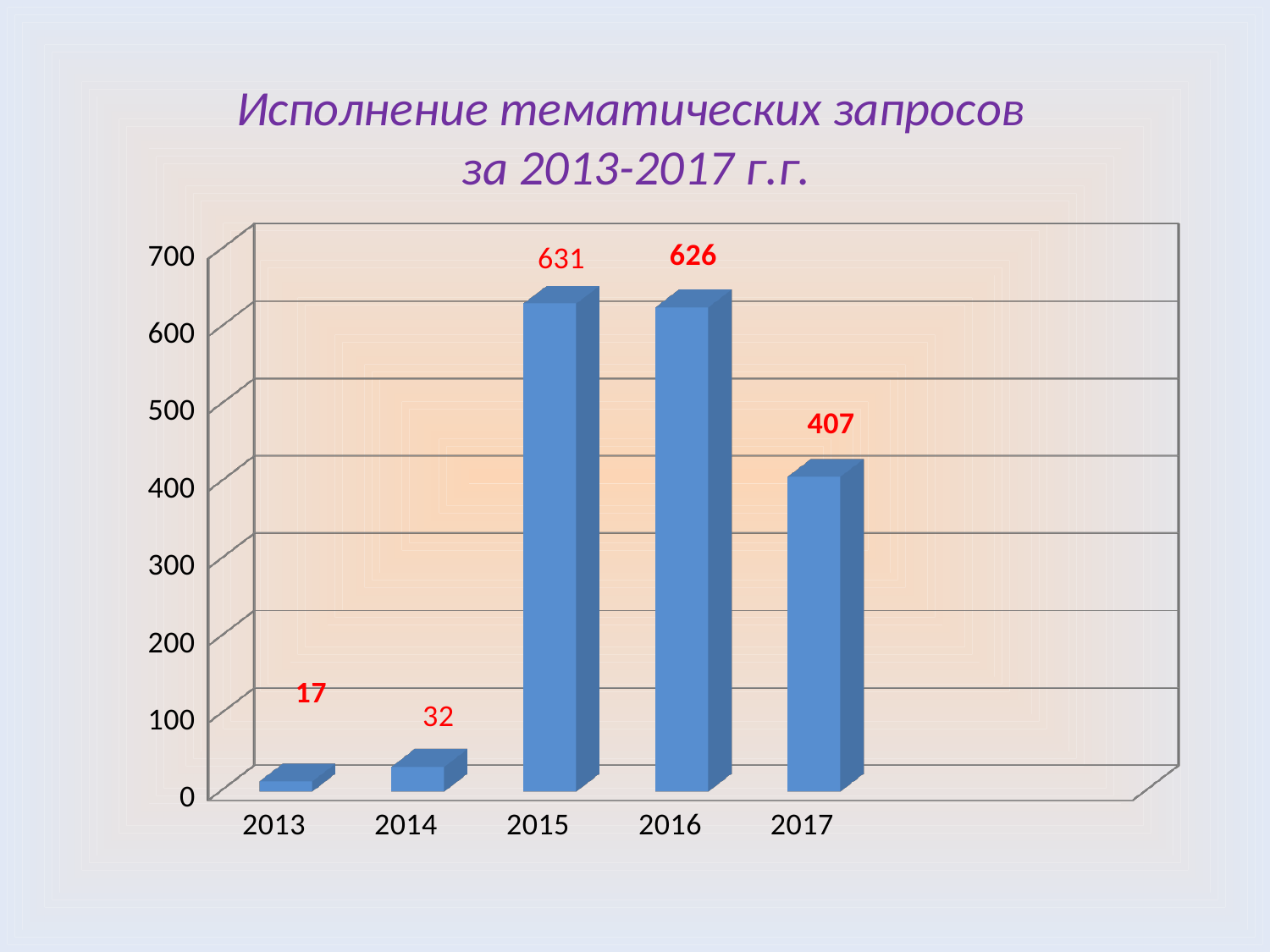
How many years are shown on the x axis? 5 What is the value for 2013? 17 Which year has the highest value? 2015 Which year has the lowest value? 2013 What kind of chart is shown on the slide? bar chart What is the value for 2017? 407 What is the difference between the values for 2016 and 2017? 219 What is the title of the chart? Исполнение тематических запросов за 2013-2017 г.г. Which is larger, the value for 2014 or the value for 2017? 2017 What is the difference between the values for 2014 and 2013? 15 What is the value for 2015? 631 Is the value for 2017 greater or less than 500? less